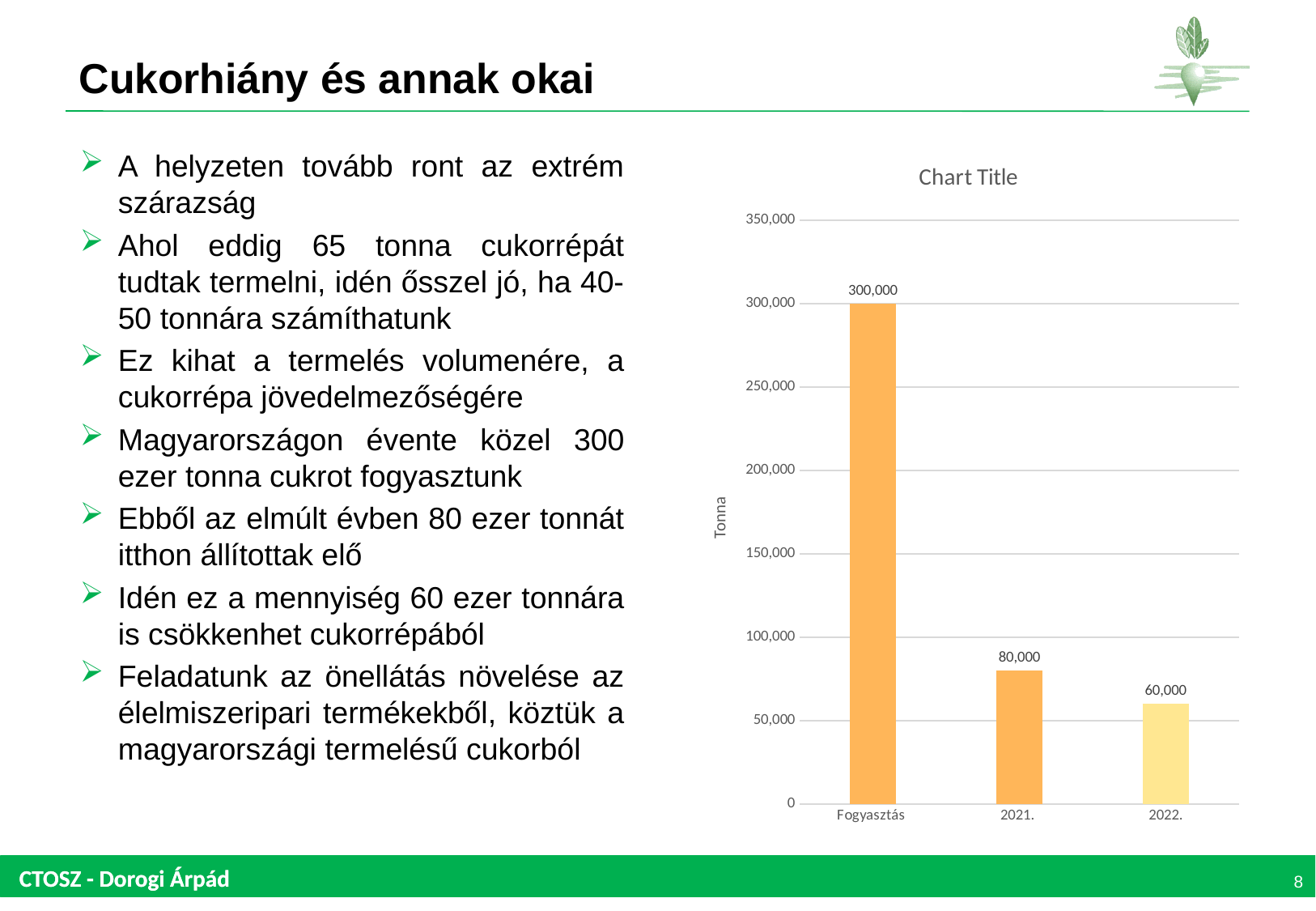
Which is larger, the value for 2021. or the value for 2022.? 2021. What is the value for Fogyasztás? 300,000 How many categories are shown on the x axis? 3 What is the difference between the values for Fogyasztás and 2021.? 220,000 Which category has the highest value? Fogyasztás Which category has the lowest value? 2022. Do the values rise or fall from left to right along the x axis? fall What is the difference between the values for 2021. and 2022.? 20,000 What kind of chart is shown on the slide? bar chart What is the value for 2021.? 80,000 What is the value for 2022.? 60,000 What is the label of the vertical axis? Tonna